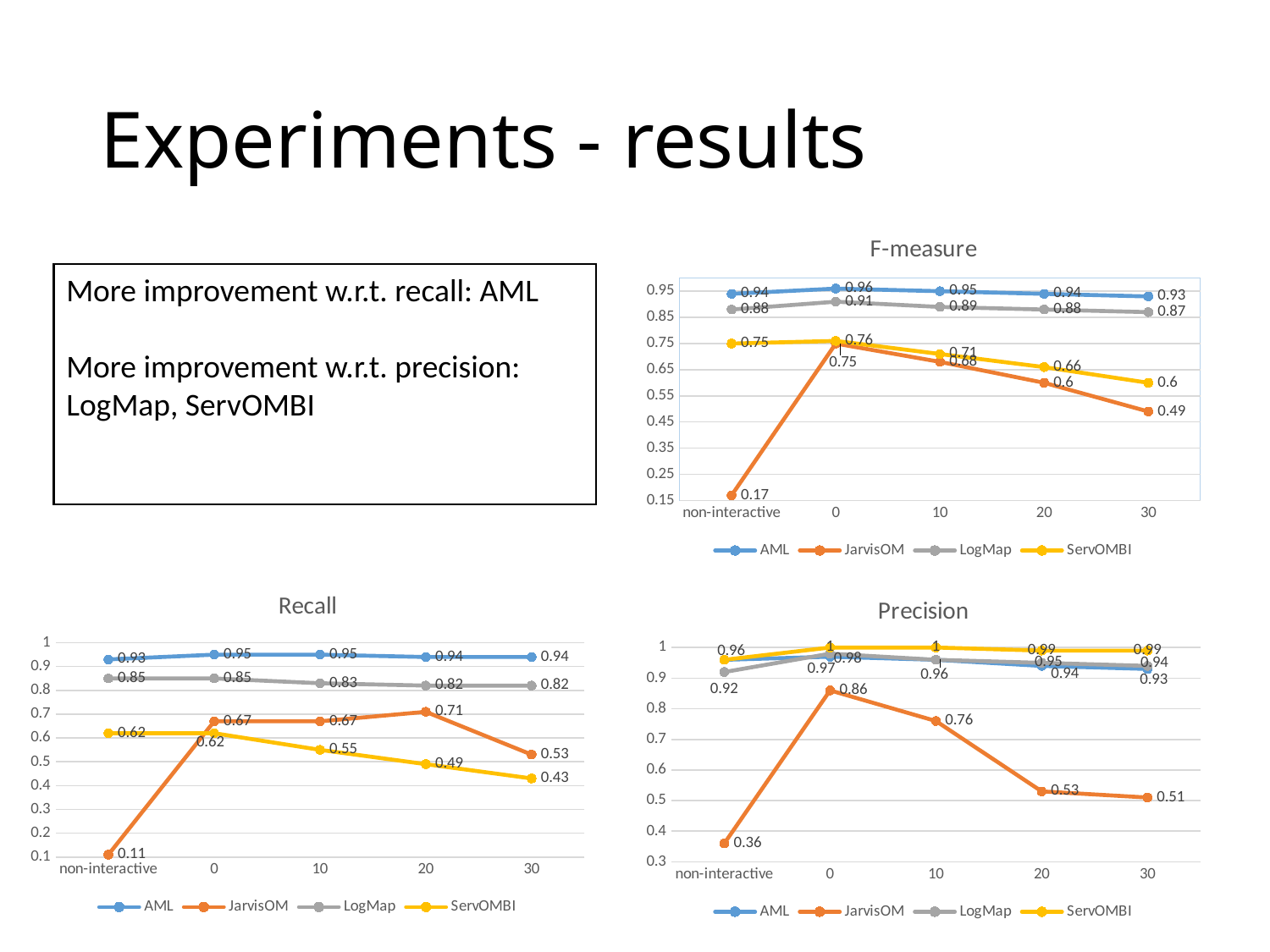
In the Recall chart, what is the value for JarvisOM at 20? 0.71 In the Recall chart, which series has the lowest value at 30? ServOMBI In the Precision chart, what is the difference between JarvisOM at 10 and at 20? 0.23 In the F-measure chart, which series has the highest value at 30? AML In the Precision chart, what is the value for JarvisOM at 0? 0.86 In the Precision chart, is the value for JarvisOM at non-interactive greater or less than 0.4? less In the F-measure chart, what is the value for ServOMBI at 30? 0.6 In the F-measure chart, what is the value for JarvisOM at non-interactive? 0.17 How many series does the legend of the Recall chart list? 4 What kind of chart is the Precision chart? line chart In the Recall chart, does the ServOMBI line rise or fall from 0 to 30? fall In the F-measure chart, what is the difference between AML and LogMap at 0? 0.05